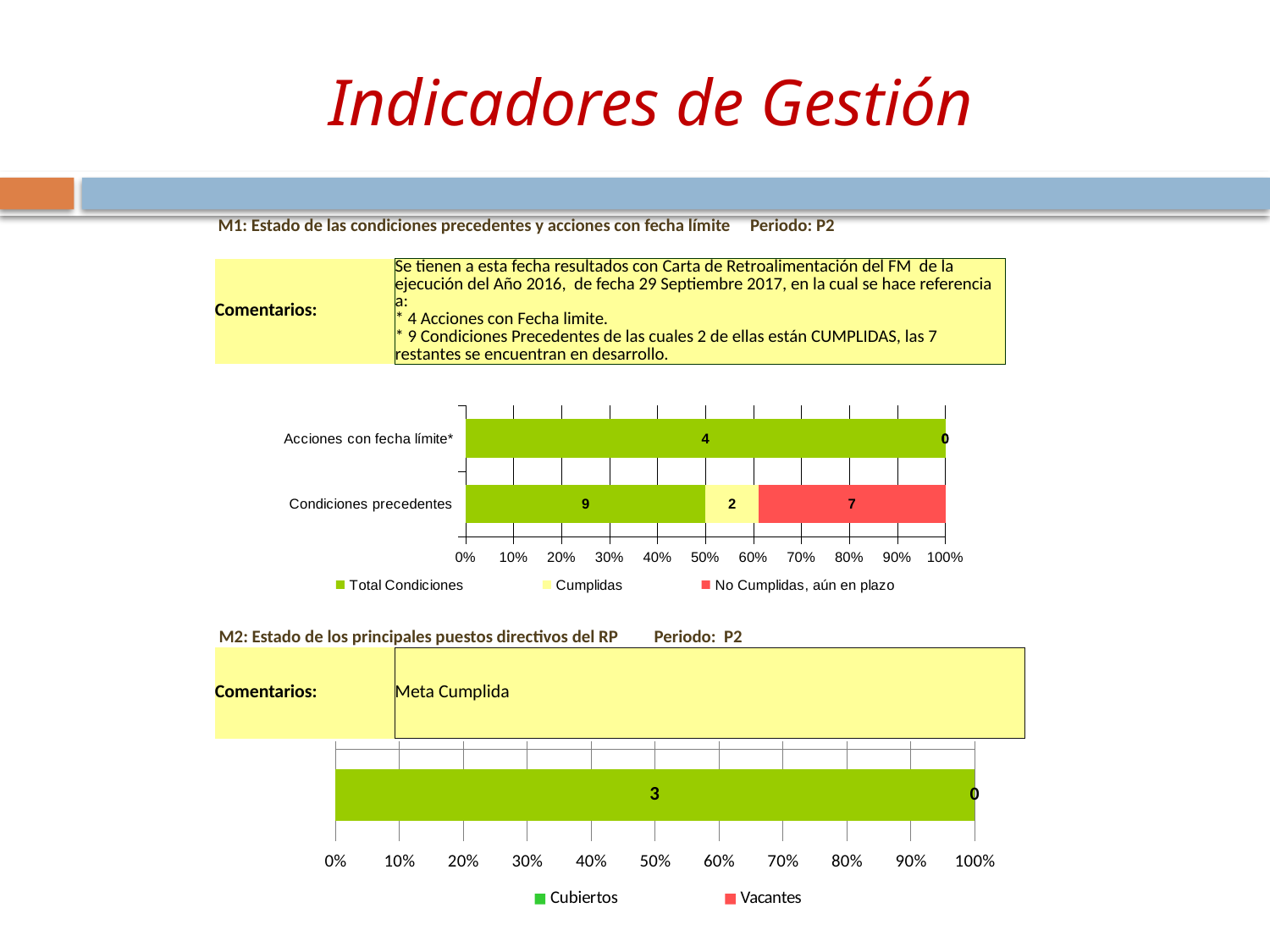
In the upper chart (M1), what is the Total Condiciones value for Acciones con fecha límite*? 4 What kind of chart is the lower chart (M2)? Bar chart In the upper chart (M1), what is the difference between the 'No Cumplidas, aún en plazo' value and the Cumplidas value for Condiciones precedentes? 5 In the upper chart (M1), what is the Cumplidas value for Condiciones precedentes? 2 In the lower chart (M2), what is the Cubiertos value? 3 In the lower chart (M2), how many series does the legend list? 2 In the upper chart (M1), which is larger for Condiciones precedentes: the Cumplidas value or the 'No Cumplidas, aún en plazo' value? No Cumplidas, aún en plazo In the lower chart (M2), what is the Vacantes value? 0 In the upper chart (M1), how many series does the legend list? 3 In the upper chart (M1), what is the Total Condiciones value for Condiciones precedentes? 9 In the upper chart (M1), what is the 'No Cumplidas, aún en plazo' value for Condiciones precedentes? 7 In the upper chart (M1), how many categories are shown on the vertical axis? 2